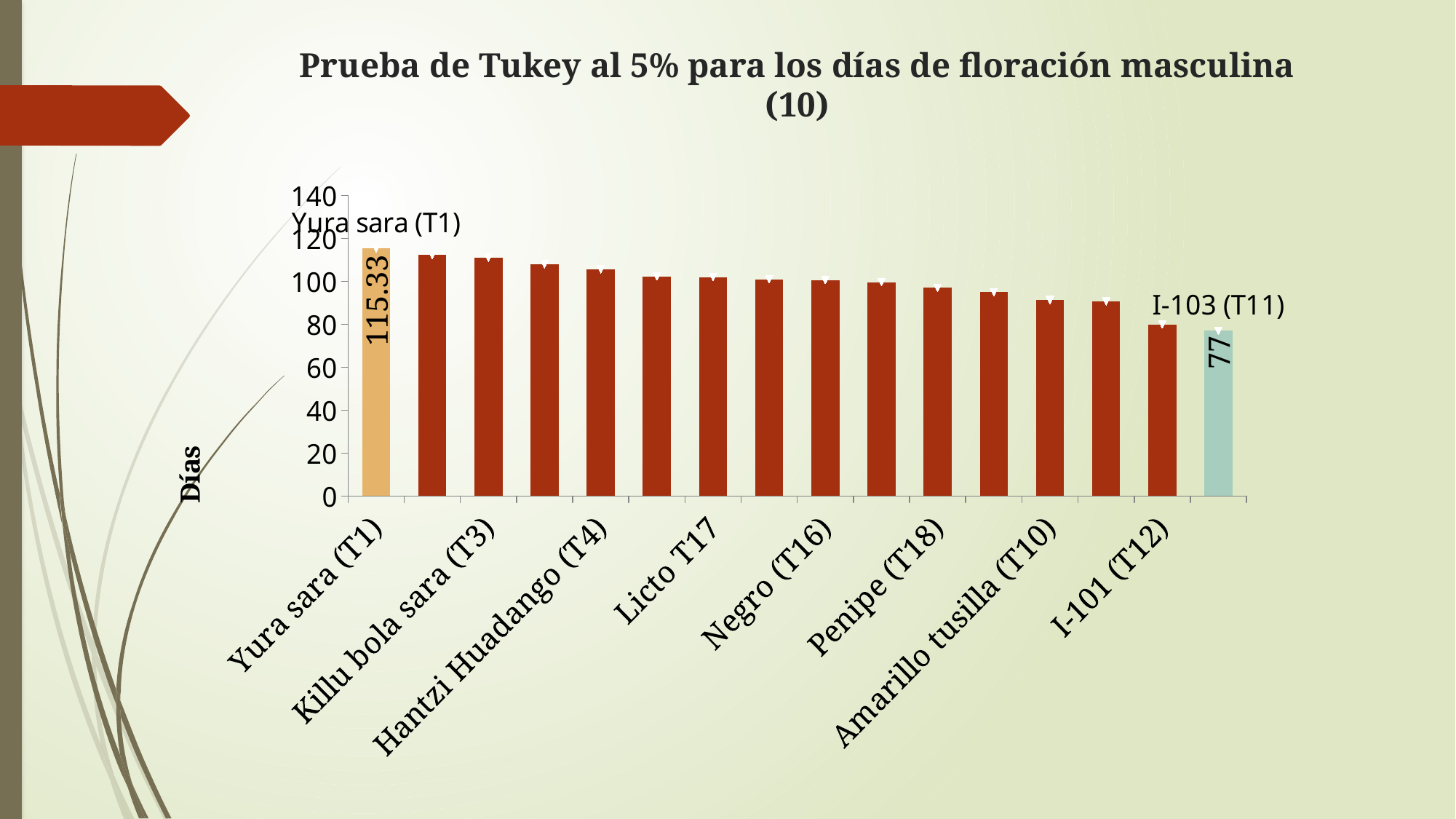
What is the difference between the values for Yura sara (T1) and I-103 (T11)? 38.33 Which category has the highest value? Yura sara (T1) Is the value for I-101 (T12) greater or less than 100? less Do the values rise or fall from left to right along the x axis? fall Is the value for Amarillo tusilla (T10) greater or less than 80? greater Is the value for Killu bola sara (T3) greater or less than 100? greater What kind of chart is shown on the slide? bar chart What is the value for I-103 (T11)? 77 How many bars are plotted in the chart? 16 Which category has the lowest value? I-103 (T11) What is the value for Yura sara (T1)? 115.33 Which is larger, the value for Yura sara (T1) or the value for I-103 (T11)? Yura sara (T1)